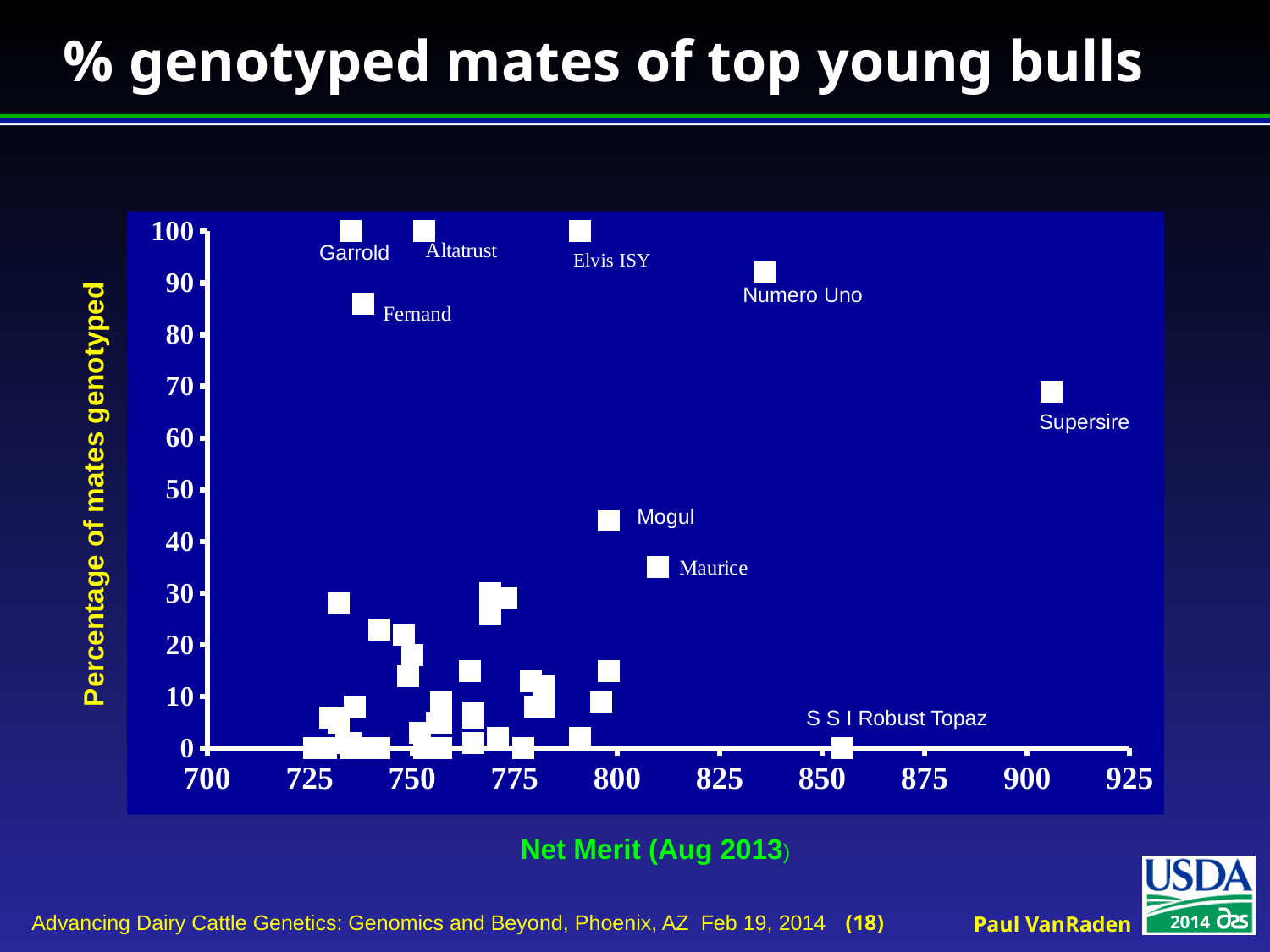
Which labeled bull has the lowest percentage of mates genotyped? S S I Robust Topaz Is the percentage of mates genotyped for Supersire greater or less than 60? greater How many bulls are labeled by name on the chart? 9 Is the Net Merit value for Supersire greater or less than 900? greater Which labeled bull has the highest Net Merit on the chart? Supersire Is the percentage of mates genotyped for Mogul greater or less than 50? less What kind of chart is shown on the slide? scatter chart Which has a higher percentage of mates genotyped, Mogul or Maurice? Mogul What is the label of the x axis of the chart? Net Merit (Aug 2013) What is the title of the chart on the slide? % genotyped mates of top young bulls Which has a higher Net Merit, Numero Uno or Supersire? Supersire